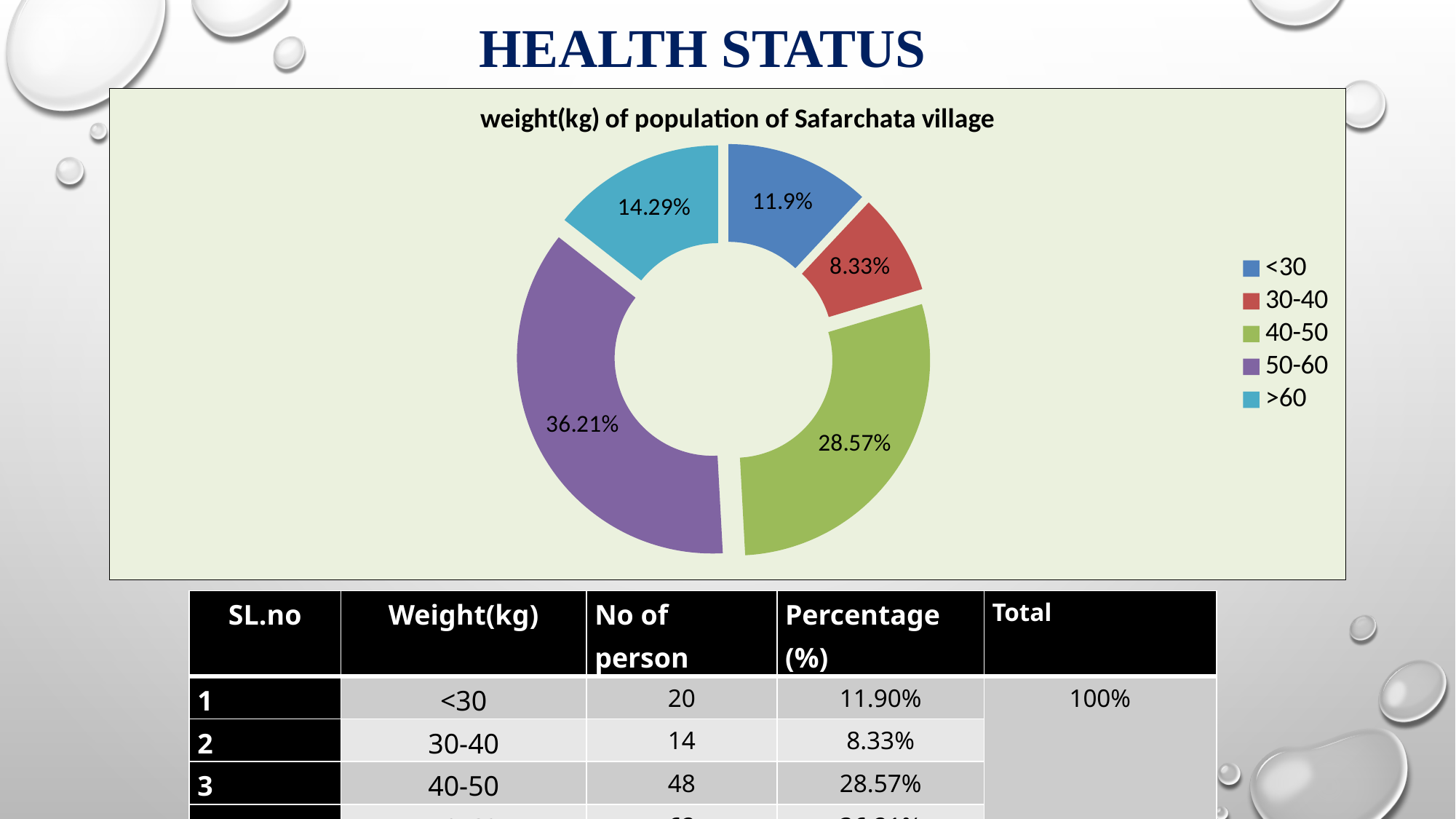
What type of chart is used to show the weight distribution? doughnut chart What is the title of the chart? weight(kg) of population of Safarchata village Which weight group has the largest share of the population? 50-60 What is the difference in percentage points between the >60 kg group and the <30 kg group? 2.39 What percentage is shown for the 40-50 kg weight group? 28.57% Which weight group has the smallest share of the population? 30-40 How many weight groups are shown in the chart? 5 What is the difference in percentage points between the 50-60 kg group and the 40-50 kg group? 7.64 What percentage of the population falls in the 50-60 kg weight group? 36.21% What percentage is shown for the <30 kg weight group? 11.9% What percentage is shown for the >60 kg weight group? 14.29% Which has a larger share, the 30-40 kg group or the >60 kg group? >60